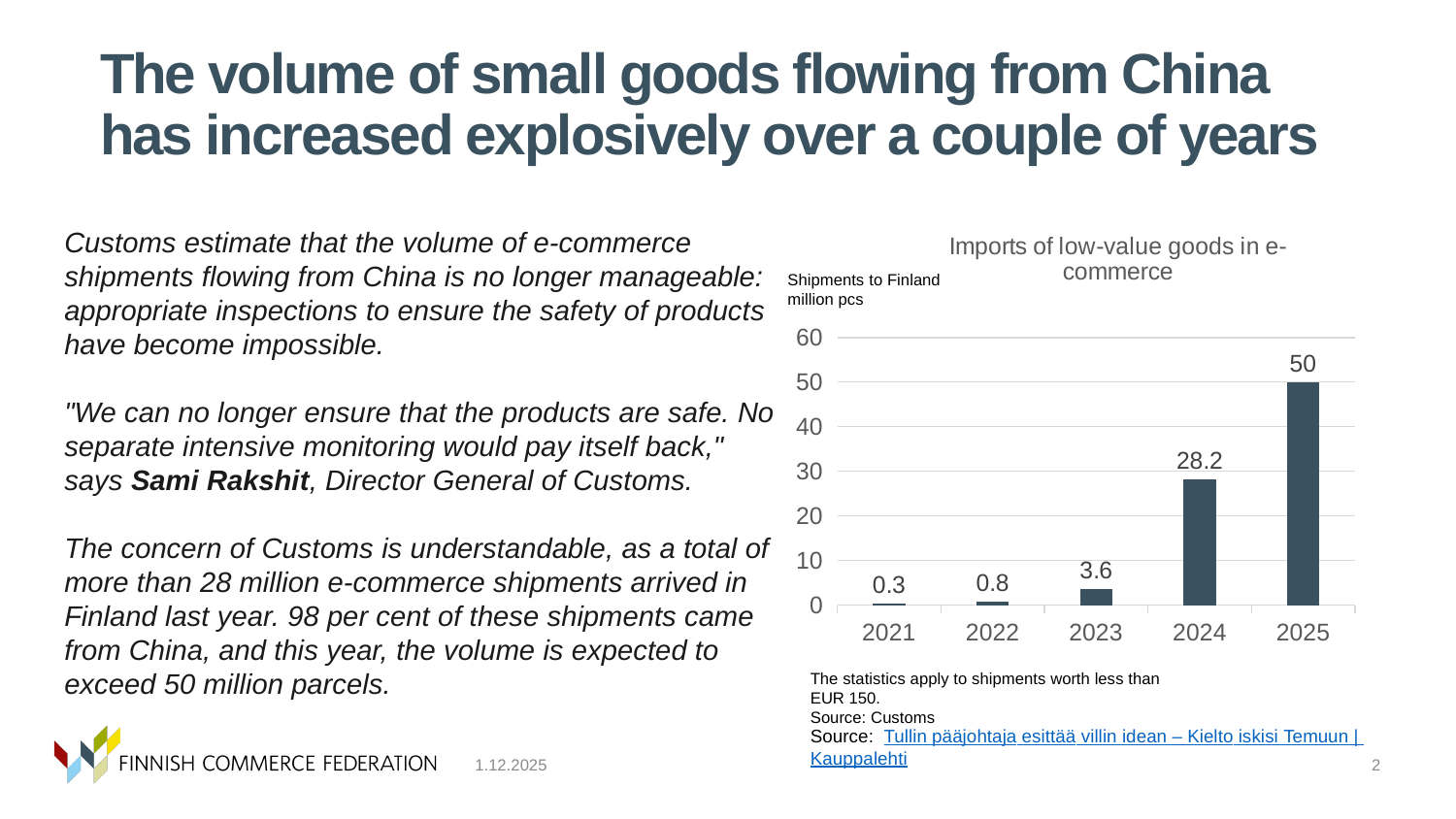
Which is larger, the value for 2022 or the value for 2023? 2023 Is the value for 2024 greater or less than 30? less What is the value for 2021? 0.3 What is the difference between the values for 2023 and 2022? 2.8 What is the value for 2024? 28.2 Do the values rise or fall from 2021 to 2025? rise Which year has the highest value? 2025 What kind of chart is shown? bar chart What is the difference between the values for 2025 and 2024? 21.8 Which year has the lowest value? 2021 How many years are shown on the x axis? 5 What is the value for 2023? 3.6